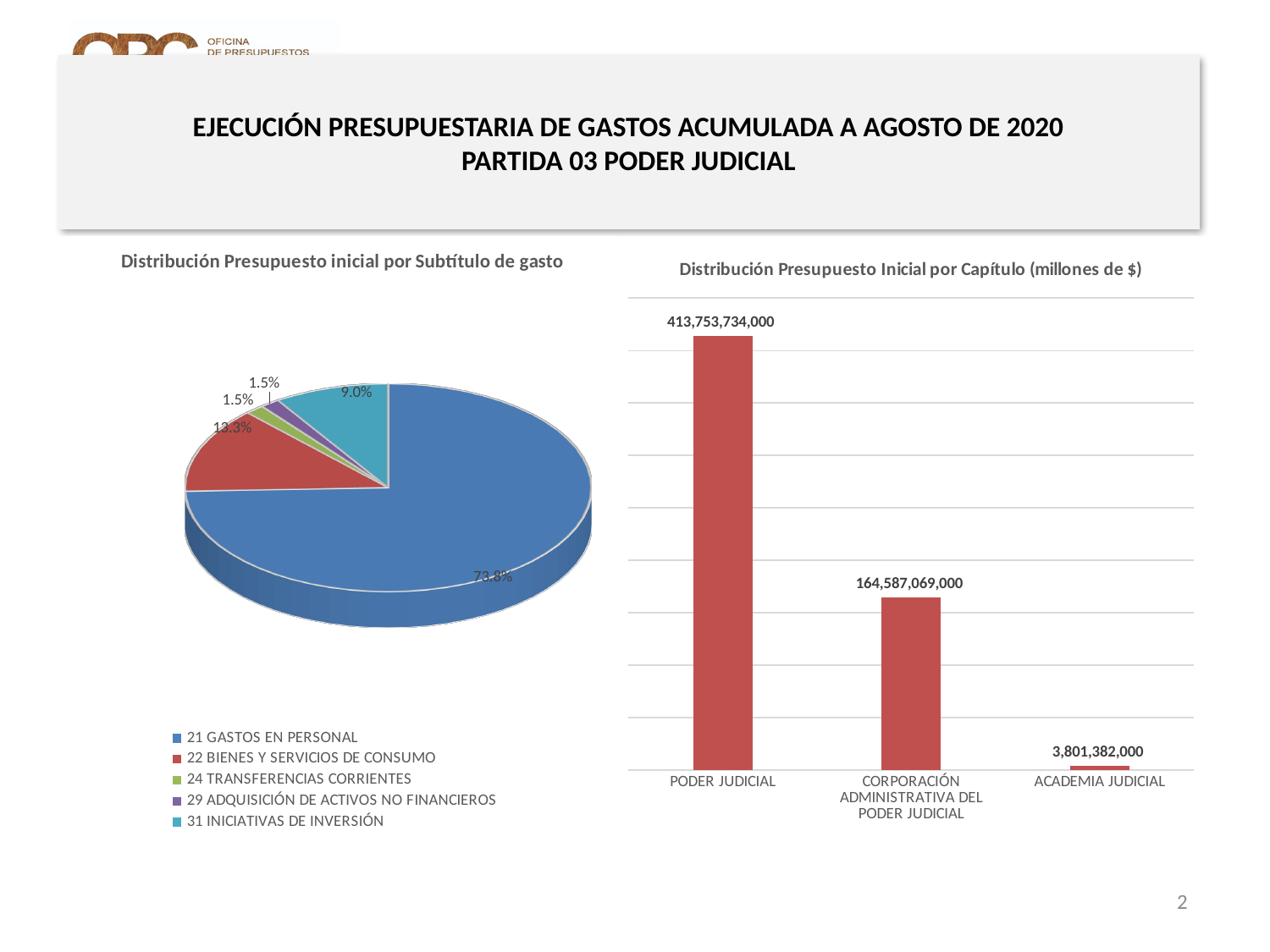
In the pie chart 'Distribución Presupuesto inicial por Subtítulo de gasto', which is larger: the share of '22 BIENES Y SERVICIOS DE CONSUMO' or the share of '31 INICIATIVAS DE INVERSIÓN'? 22 BIENES Y SERVICIOS DE CONSUMO In the bar chart 'Distribución Presupuesto Inicial por Capítulo (millones de $)', what is the value for ACADEMIA JUDICIAL? 3,801,382,000 In the pie chart 'Distribución Presupuesto inicial por Subtítulo de gasto', what share does '22 BIENES Y SERVICIOS DE CONSUMO' have? 13.3% In the bar chart 'Distribución Presupuesto Inicial por Capítulo (millones de $)', what is the value for PODER JUDICIAL? 413,753,734,000 What kind of chart is 'Distribución Presupuesto Inicial por Capítulo (millones de $)'? Bar chart How many categories does the legend of the pie chart 'Distribución Presupuesto inicial por Subtítulo de gasto' list? 5 In the pie chart 'Distribución Presupuesto inicial por Subtítulo de gasto', what share does '21 GASTOS EN PERSONAL' have? 73.8% In the pie chart 'Distribución Presupuesto inicial por Subtítulo de gasto', which category has the largest slice? 21 GASTOS EN PERSONAL In the pie chart 'Distribución Presupuesto inicial por Subtítulo de gasto', what share does '31 INICIATIVAS DE INVERSIÓN' have? 9.0% In the bar chart 'Distribución Presupuesto Inicial por Capítulo (millones de $)', which category has the lowest value? ACADEMIA JUDICIAL In the bar chart 'Distribución Presupuesto Inicial por Capítulo (millones de $)', what is the difference between the values for PODER JUDICIAL and CORPORACIÓN ADMINISTRATIVA DEL PODER JUDICIAL? 249,166,665,000